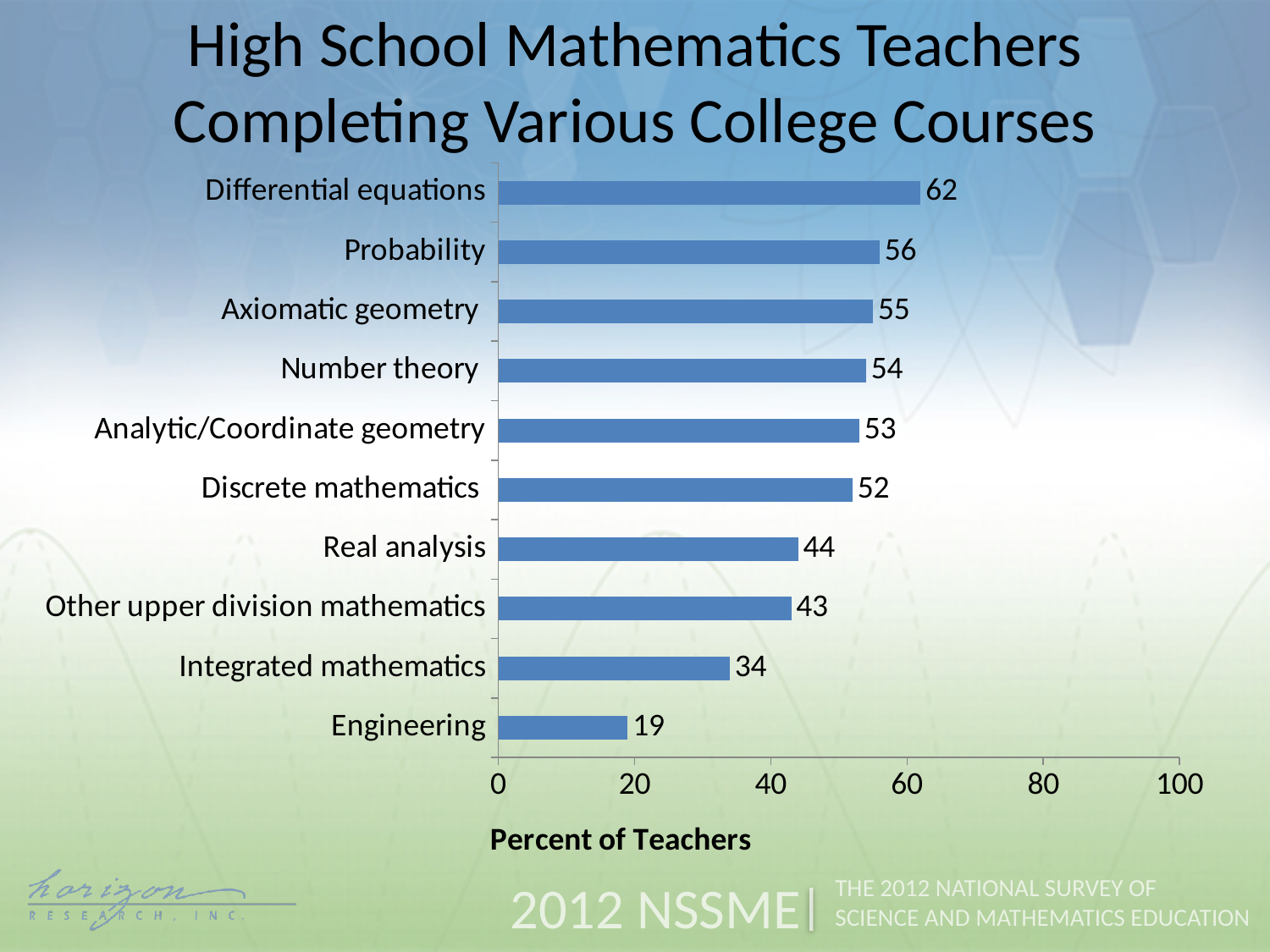
What is the value shown for Real analysis? 44 What is the label of the horizontal axis? Percent of Teachers What is the difference between the values for Differential equations and Discrete mathematics? 10 Which course has the lowest percent of teachers? Engineering What is the difference between the values for Probability and Engineering? 37 What percent of high school mathematics teachers completed Differential equations? 62 Which course has the highest percent of teachers? Differential equations Is the value for Axiomatic geometry greater or less than 40? greater Which is larger, the value for Number theory or the value for Other upper division mathematics? Number theory What is the value shown for Integrated mathematics? 34 What kind of chart is shown on the slide? Bar chart How many courses are shown in the chart? 10